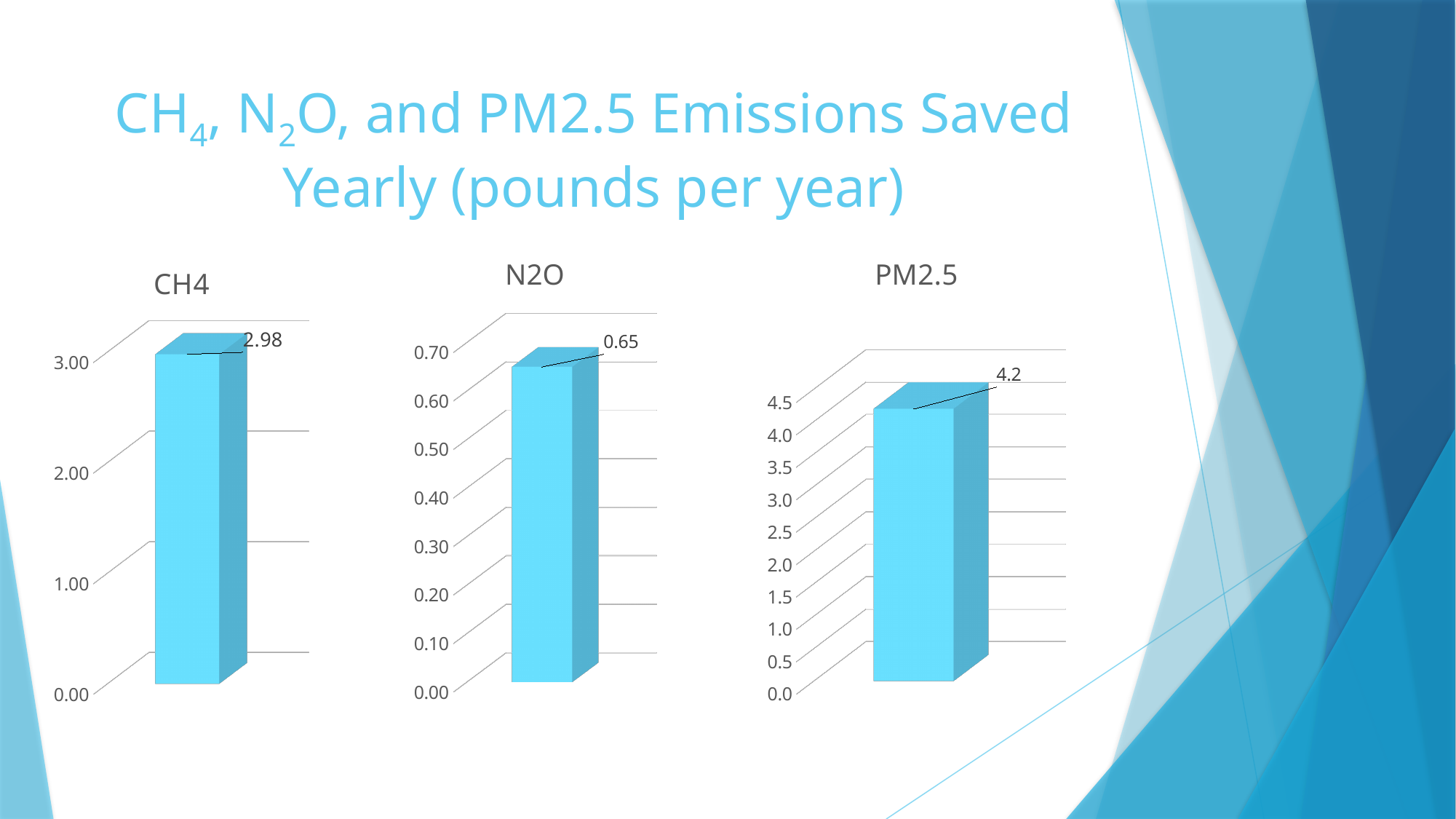
In the CH4 chart, is the bar's value greater or less than 2.00? greater How many charts are shown on the slide? 3 In the PM2.5 chart, what value is shown by the data label on the bar? 4.2 In the N2O chart, is the bar's value greater or less than 0.70? less What is the title of the chart on the right of the slide? PM2.5 In the N2O chart, what value is shown by the data label on the bar? 0.65 In the N2O chart, what is the highest value shown on the vertical axis? 0.70 What kind of chart is the CH4 chart? bar chart How many bars are plotted in the N2O chart? 1 In the CH4 chart, what value is shown by the data label on the bar? 2.98 In the PM2.5 chart, is the bar's value greater or less than 4.0? greater